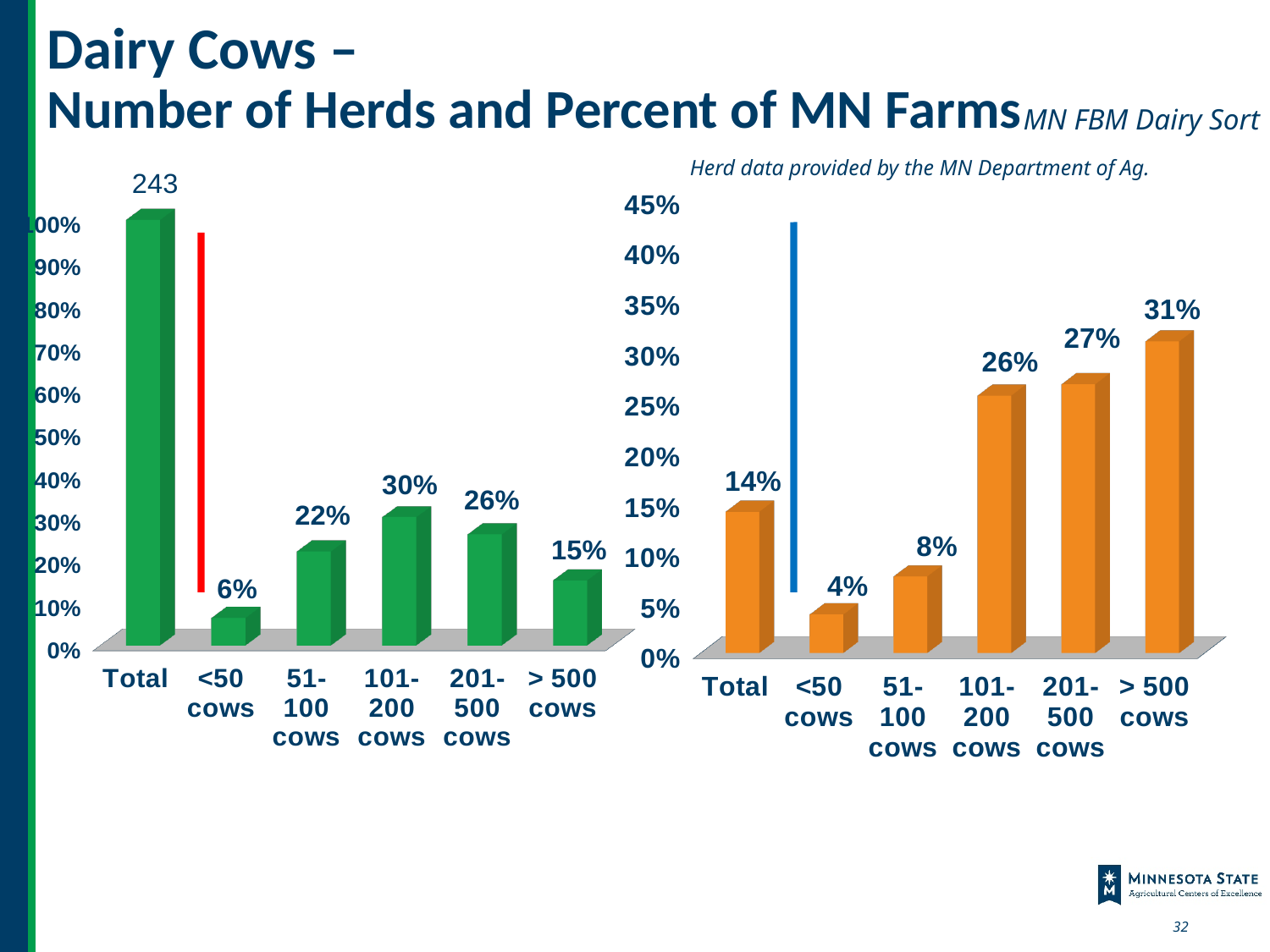
In the left chart, what is the difference between the 51-100 cows value and the > 500 cows value? 7% In the left chart, what is the value for the <50 cows category? 6% In the right chart, which category has the lowest value? <50 cows In the right chart, which is larger, the value for 51-100 cows or the value for 101-200 cows? 101-200 cows In the left chart, what is the value for the 101-200 cows category? 30% In the right chart, what is the value for the Total category? 14% How many bars are plotted in the right chart? 6 In the right chart, what is the difference between the > 500 cows value and the <50 cows value? 27% In the left chart, excluding Total, which herd-size category has the highest value? 101-200 cows In the right chart, what is the value for the > 500 cows category? 31% What type of chart is the left chart? Bar chart In the left chart, what number is printed above the Total bar? 243